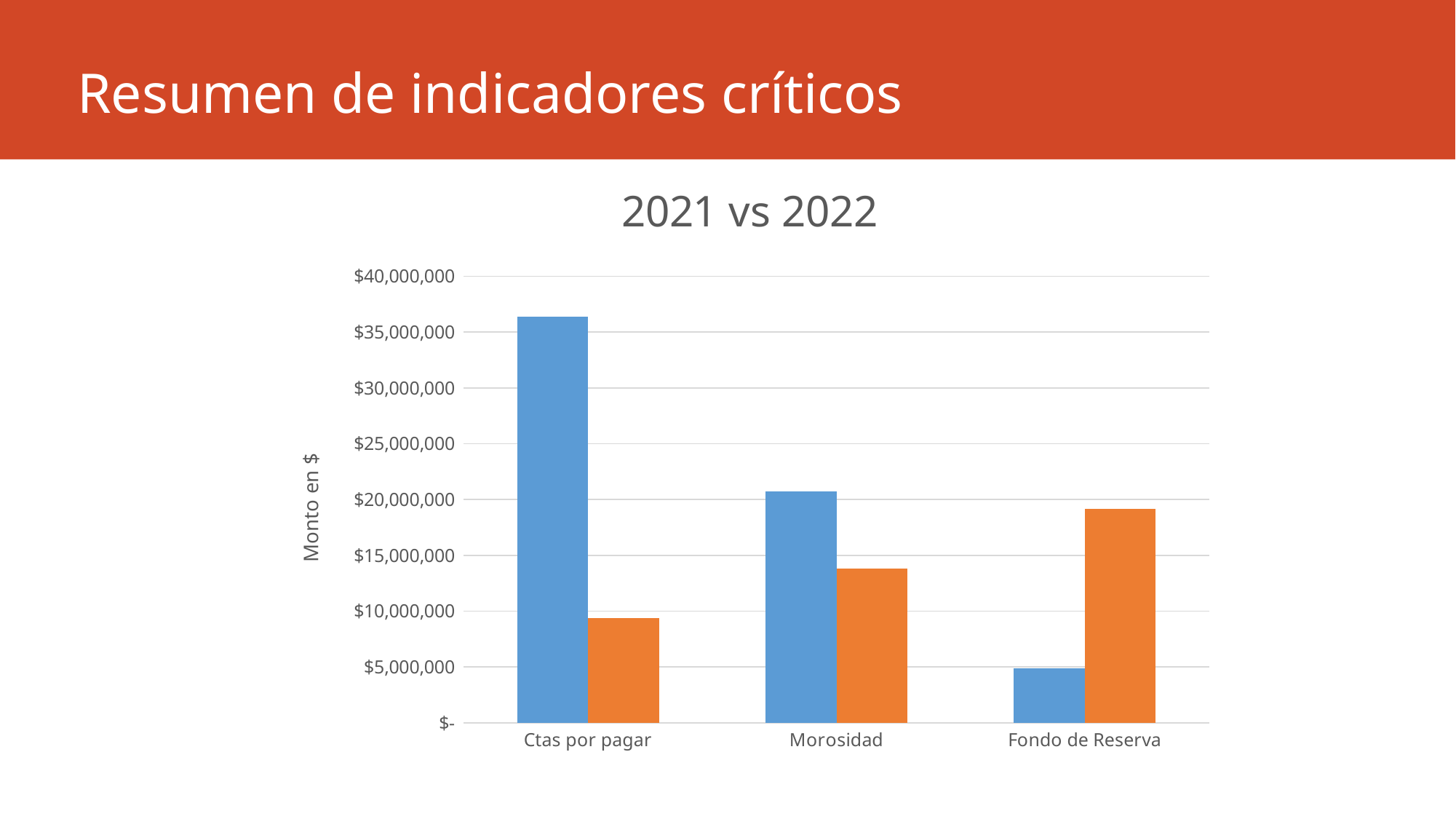
What is the label of the vertical axis of the chart? Monto en $ What kind of chart is shown on the slide? bar chart Which category has the shortest bar in the chart? Fondo de Reserva How many categories are shown on the x axis of the chart? 3 For Fondo de Reserva, which bar is taller, the blue bar or the orange bar? the orange bar Is the orange bar for Fondo de Reserva greater or less than $15,000,000? greater Is the blue bar for Fondo de Reserva greater or less than $10,000,000? less Is the orange bar for Ctas por pagar greater or less than $10,000,000? less What is the title of the chart? 2021 vs 2022 Which category has the tallest bar in the chart? Ctas por pagar